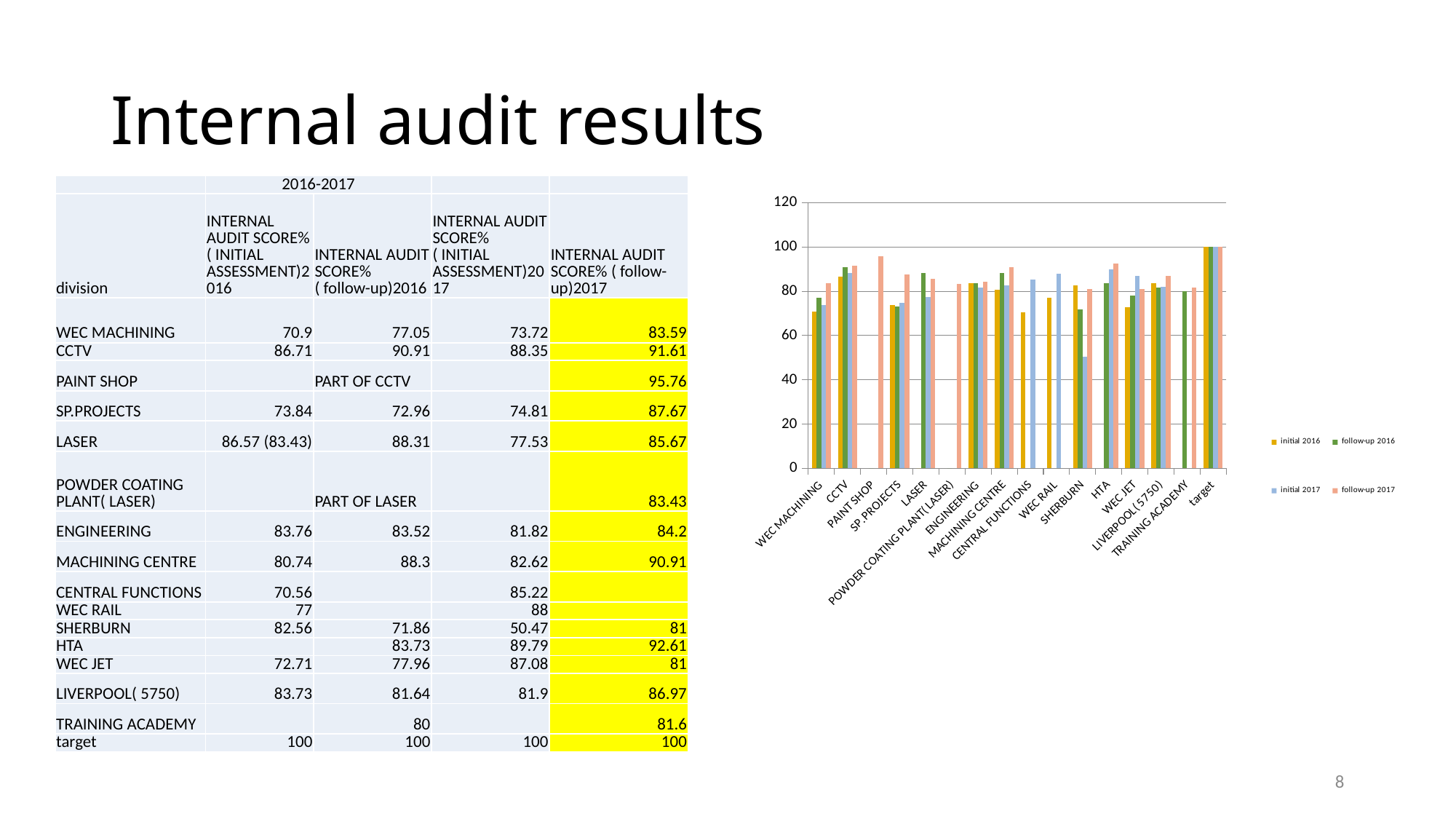
Is the initial 2016 value for WEC MACHINING greater or less than 80? less Which is larger in the chart: the initial 2017 value for SHERBURN or the initial 2017 value for HTA? HTA Is the follow-up 2016 value for CCTV greater or less than 80? greater Is the initial 2017 value for SHERBURN greater or less than 60? less Excluding the target category, which category has the tallest follow-up 2017 bar? PAINT SHOP What is the value of the target bars in the chart? 100 What are the four series named in the chart's legend? initial 2016, follow-up 2016, initial 2017, follow-up 2017 Which category has the lowest initial 2017 bar in the chart? SHERBURN How many series does the chart's legend list? 4 What kind of chart is shown on the slide? bar chart How many categories are shown along the x axis of the chart? 16